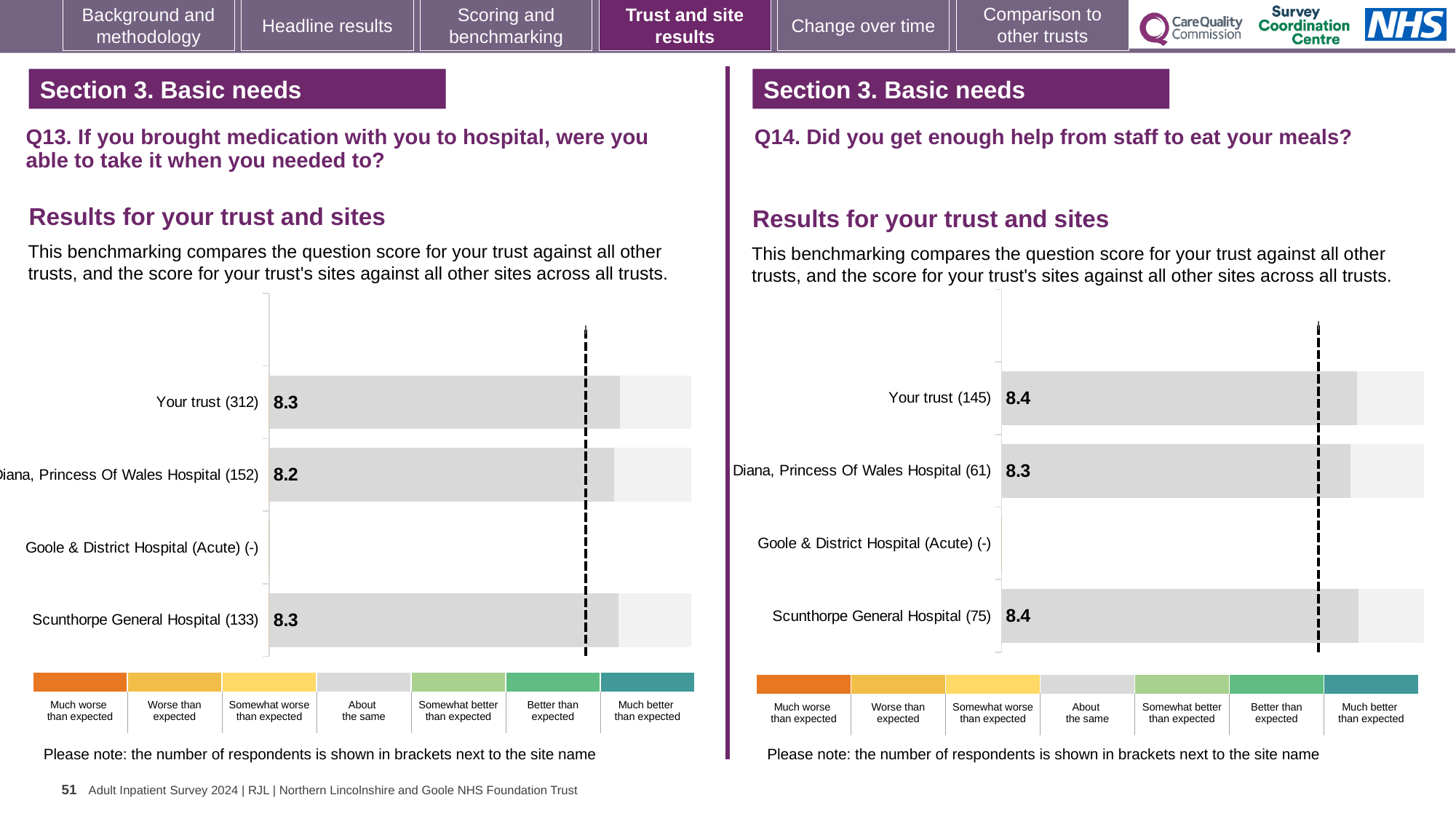
In the Q13 chart on the left, how many categories are listed on the vertical axis? 4 In the Q14 chart on the right, what is the score for Your trust? 8.4 In the Q14 chart on the right, which site with a printed score has the lowest score? Diana, Princess Of Wales Hospital In the Q13 chart on the left, what is the score for Your trust? 8.3 In the Q14 chart on the right, what is the score for Diana, Princess Of Wales Hospital? 8.3 In the Q13 chart on the left, how many respondents are shown in brackets for Your trust? 312 In the Q13 chart on the left, what is the score for Scunthorpe General Hospital? 8.3 What kind of chart is the Q14 chart on the right? Bar chart In the Q14 chart on the right, what is the difference between the score for Your trust and the score for Diana, Princess Of Wales Hospital? 0.1 In the Q13 chart on the left, which site with a printed score has the lowest score? Diana, Princess Of Wales Hospital In the Q14 chart on the right, what is the score for Scunthorpe General Hospital? 8.4 In the Q13 chart on the left, what is the score for Diana, Princess Of Wales Hospital? 8.2